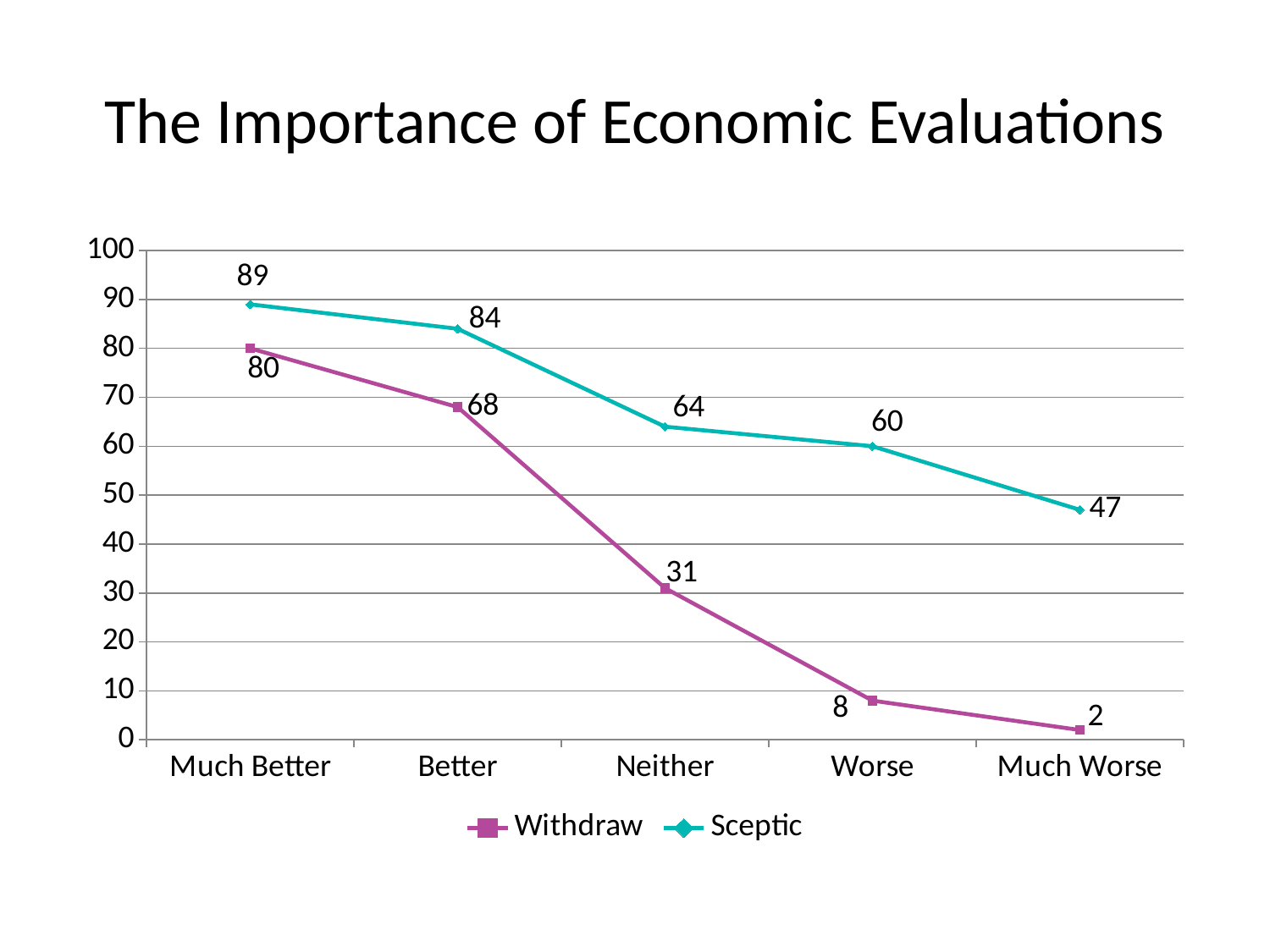
Which category has the lowest Withdraw value? Much Worse Do the Withdraw values rise or fall from Much Better to Much Worse? Fall What kind of chart is shown on the slide? Line chart What is the difference between the Withdraw values for Better and Neither? 37 Which category has the highest Sceptic value? Much Better What is the difference between the Sceptic and Withdraw values for Worse? 52 How many categories are shown on the x axis? 5 Which is larger for Better: the Withdraw value or the Sceptic value? Sceptic How many series does the legend list? 2 What is the Withdraw value for Neither? 31 What is the Withdraw value for Much Better? 80 What is the Sceptic value for Much Worse? 47